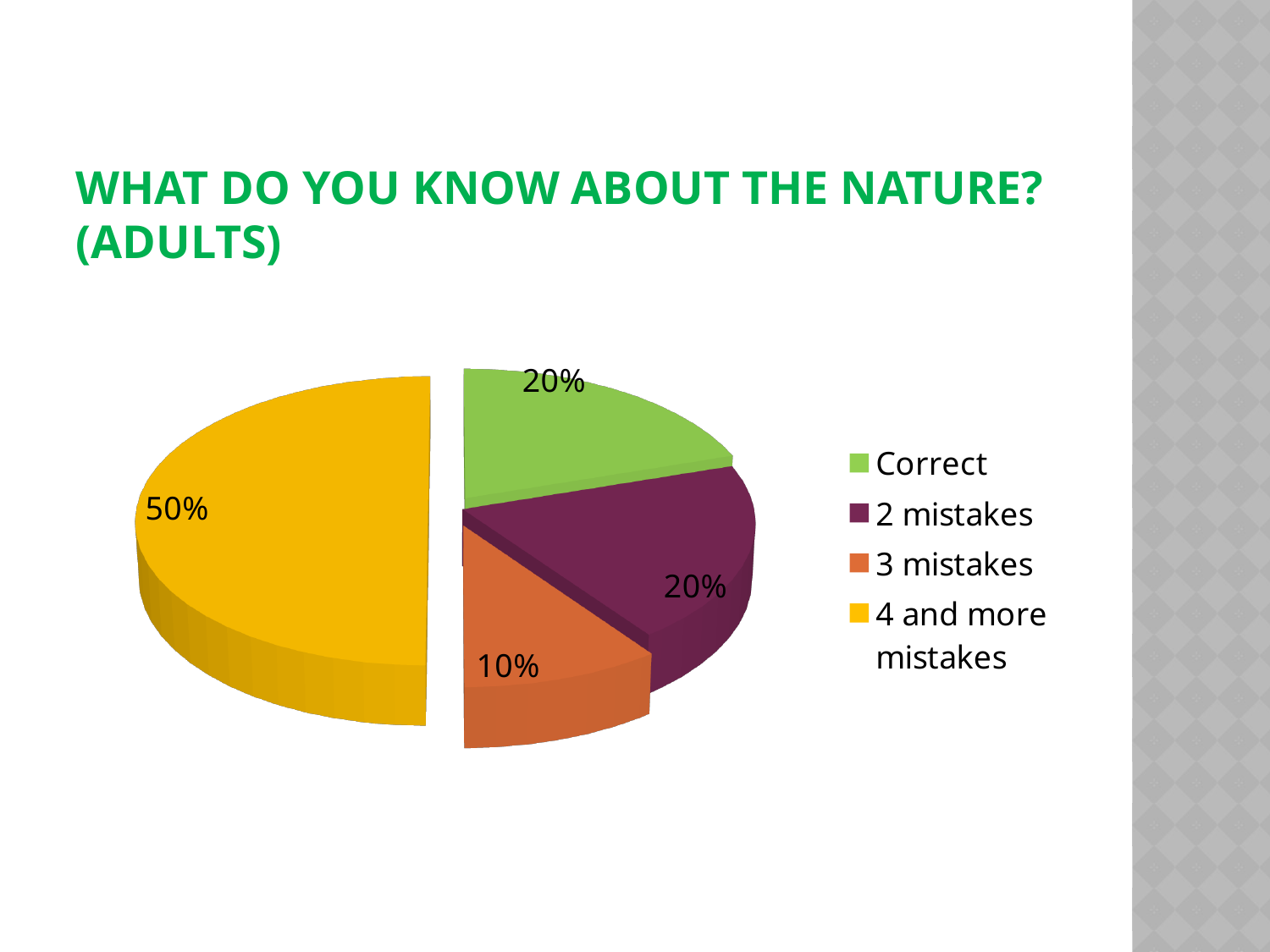
What is the title of the slide containing the chart? What do you know about the nature? (Adults) Which is larger, the share for "2 mistakes" or the share for "3 mistakes"? 2 mistakes What share of the pie is labelled "4 and more mistakes"? 50% Which category has the smallest slice of the pie? 3 mistakes Which category has the largest slice of the pie? 4 and more mistakes What is the difference between the share for "4 and more mistakes" and the share for "Correct"? 30% How many categories does the pie chart have? 4 What share of the pie is labelled "2 mistakes"? 20% What colour is the slice for "4 and more mistakes"? yellow What share of the pie is labelled "Correct"? 20% What kind of chart is shown on the slide? pie chart